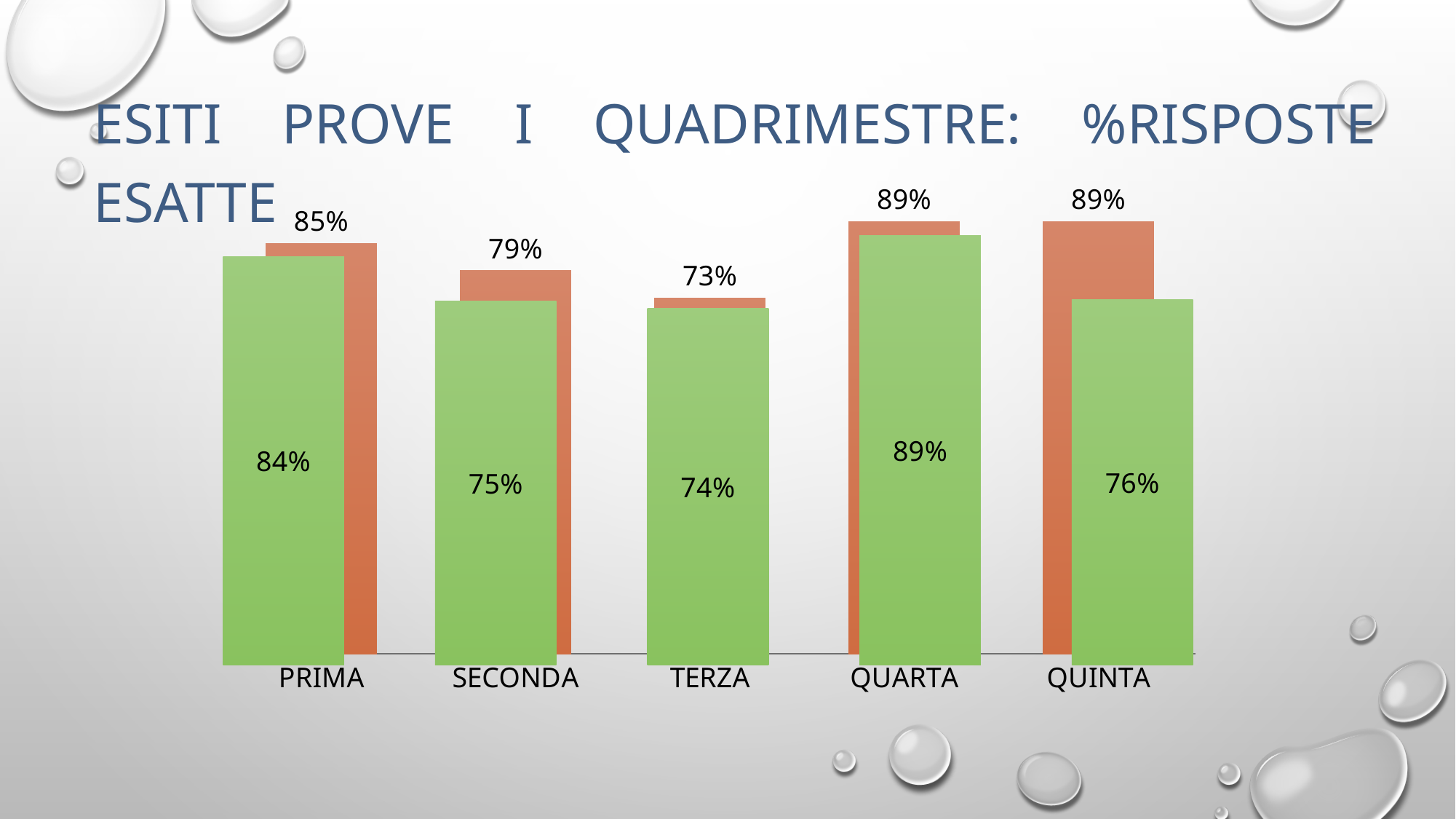
What is the title of the slide containing the chart? ESITI PROVE I QUADRIMESTRE: %RISPOSTE ESATTE Which is larger for SECONDA, the green bar or the orange bar? the orange bar What kind of chart is shown on the slide? bar chart What is the value of the green bar for PRIMA? 84% How many categories are shown on the x axis of the chart? 5 Which category has the highest value for the green bars? QUARTA What is the value of the orange bar for TERZA? 73% What is the difference between the orange bar and the green bar for QUINTA? 13% What is the difference between the green bar values for QUARTA and SECONDA? 14% Which category has the lowest value for the green bars? TERZA What is the value of the orange bar for SECONDA? 79% What is the value of the green bar for QUINTA? 76%